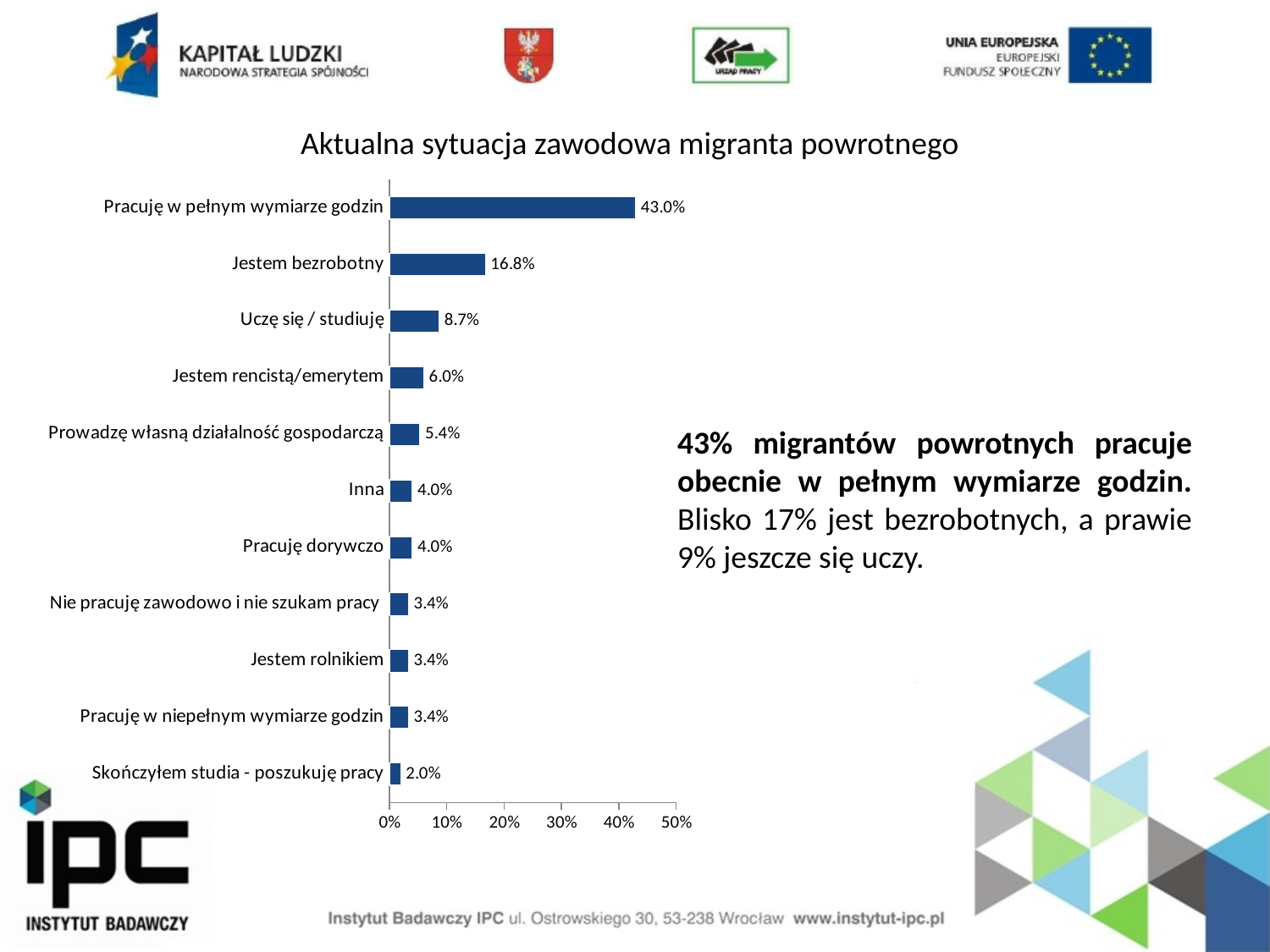
What is the value for "Pracuję w pełnym wymiarze godzin"? 43.0% Which category has the highest value? Pracuję w pełnym wymiarze godzin Which category has the lowest value? Skończyłem studia - poszukuję pracy What is the value for "Uczę się / studiuję"? 8.7% What is the title of the chart? Aktualna sytuacja zawodowa migranta powrotnego What is the value for "Skończyłem studia - poszukuję pracy"? 2.0% Which is larger, "Jestem rencistą/emerytem" or "Prowadzę własną działalność gospodarczą"? Jestem rencistą/emerytem What kind of chart is shown on the slide? bar chart Is the value for "Jestem bezrobotny" greater or less than 20%? less What is the value for "Jestem bezrobotny"? 16.8% How many categories are shown in the chart? 11 What is the difference between "Pracuję w pełnym wymiarze godzin" and "Jestem bezrobotny"? 26.2%